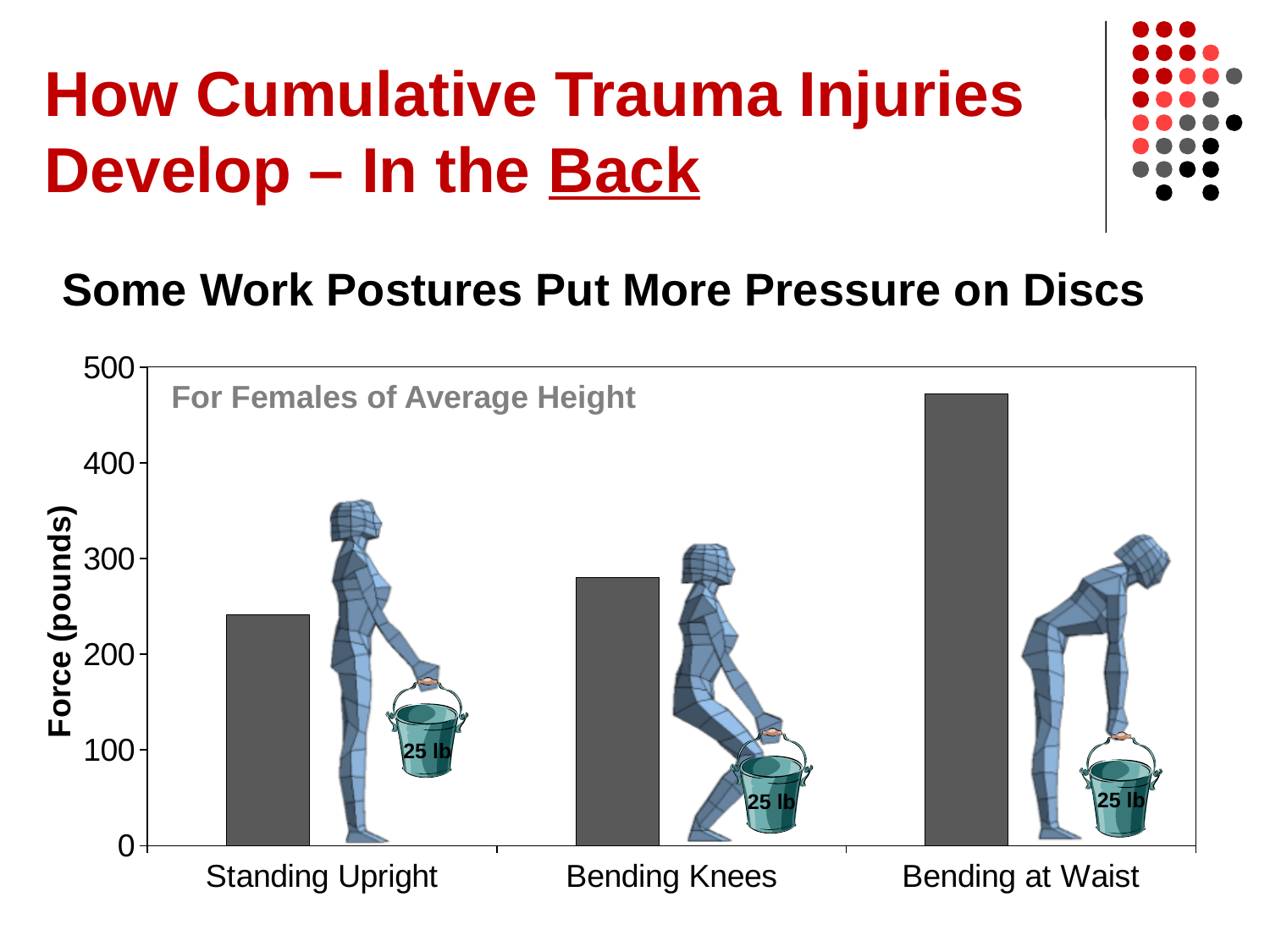
Is the value for Standing Upright greater or less than 300? less Is the value for Bending at Waist greater or less than 400? greater Which posture has the lowest force value? Standing Upright What is the label on the vertical axis of the chart? Force (pounds) Which has a larger force value, Bending Knees or Standing Upright? Bending Knees Do the force values rise or fall moving from Standing Upright to Bending at Waist along the x axis? rise What group does the note inside the chart say the data is for? For Females of Average Height Is the value for Bending Knees greater or less than 200? greater Which has a larger force value, Bending at Waist or Bending Knees? Bending at Waist Which posture has the highest force value? Bending at Waist What kind of chart is shown on the slide? bar chart How many postures (categories) are plotted on the chart? 3